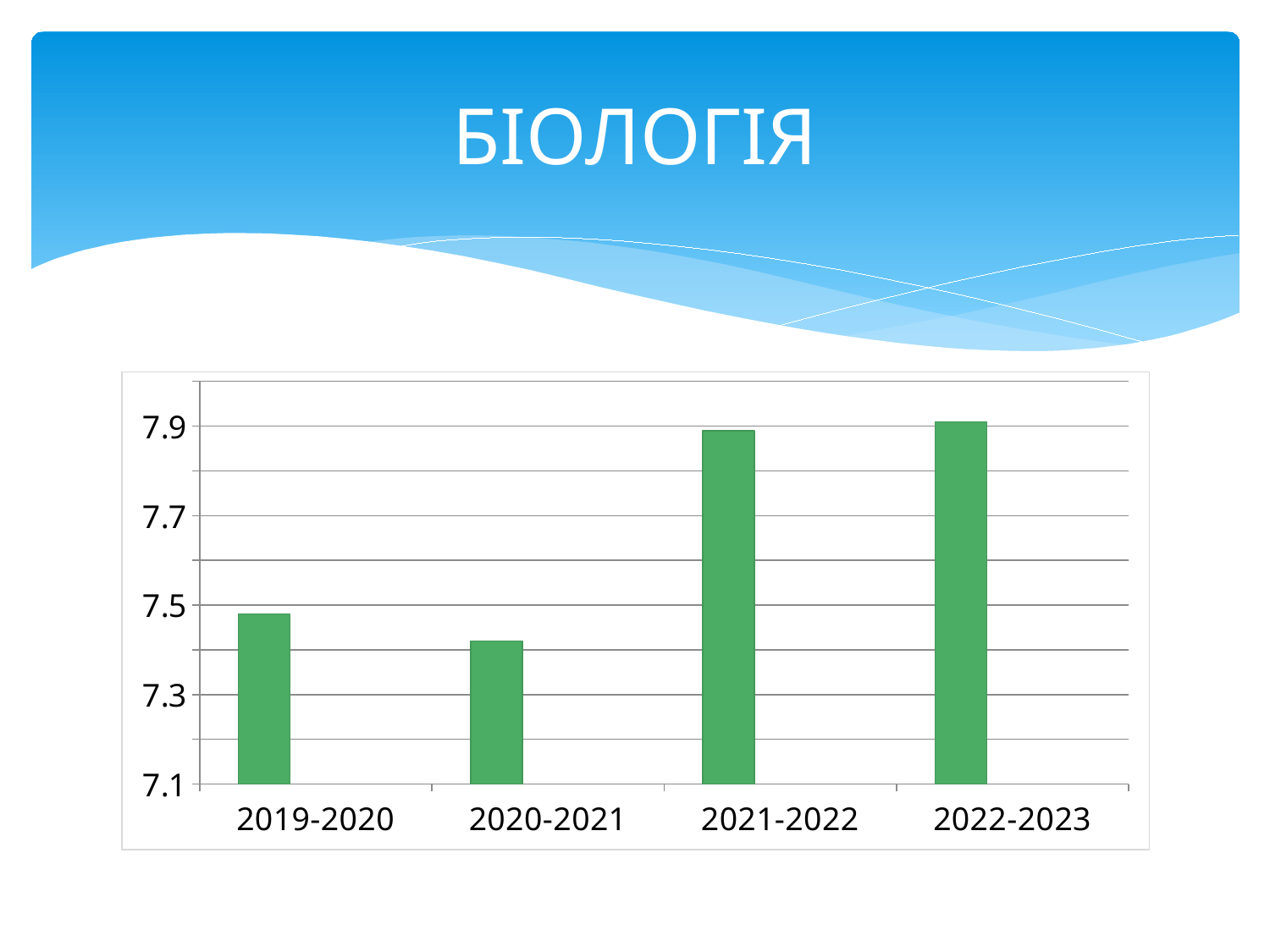
Is the value for 2021-2022 greater or less than 7.7? greater Which is larger, the value for 2019-2020 or the value for 2021-2022? 2021-2022 Is the value for 2019-2020 greater or less than 7.3? greater Which school year has the lowest bar in the chart? 2020-2021 What kind of chart is shown on the slide? bar chart Which is larger, the value for 2020-2021 or the value for 2022-2023? 2022-2023 How many categories (school years) are shown on the x axis of the chart? 4 Is the value for 2020-2021 greater or less than 7.5? less What colour are the bars in the chart? green Does the value rise or fall from 2020-2021 to 2021-2022? rise What is the title of the slide containing the chart? БІОЛОГІЯ